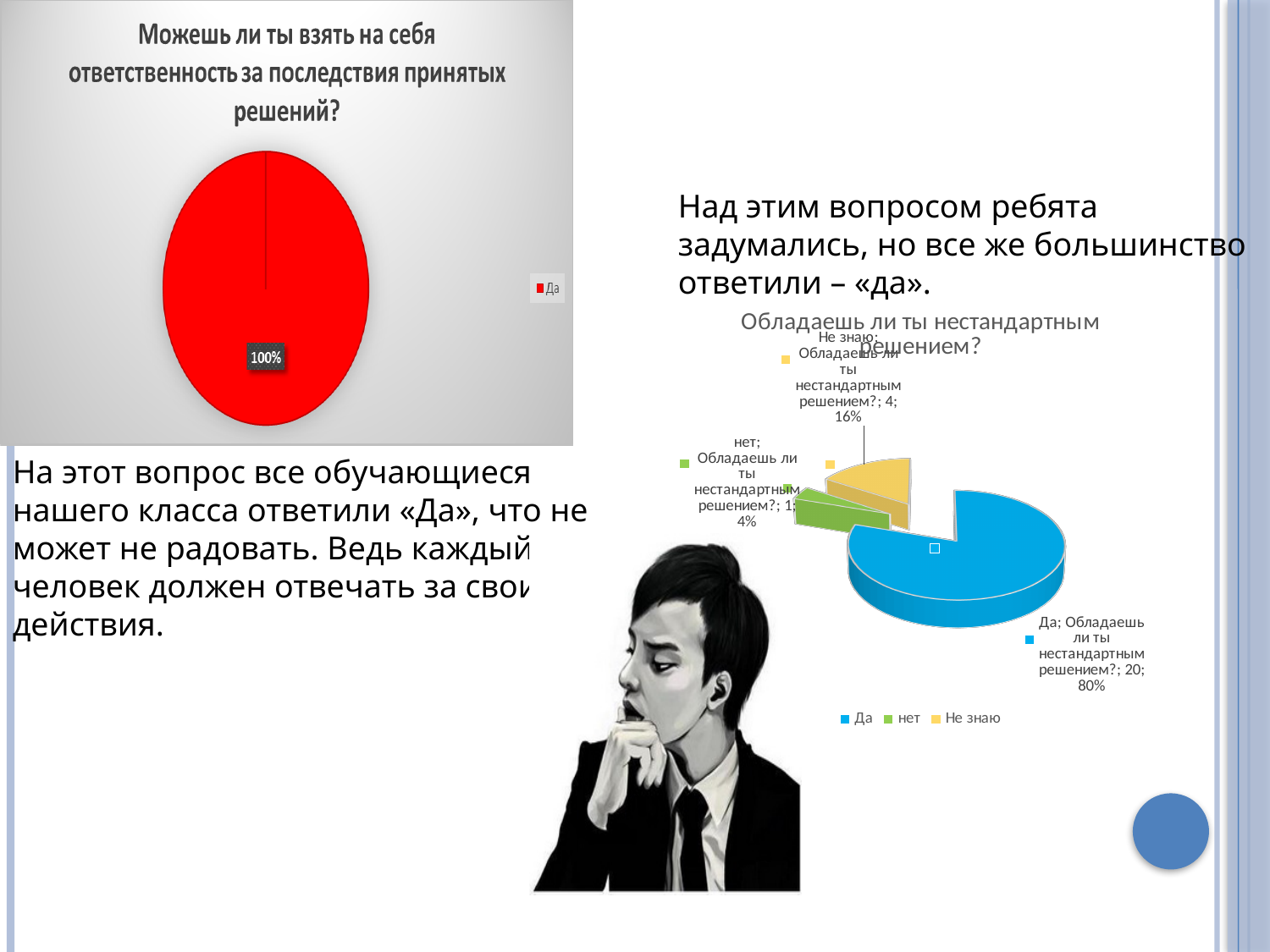
On the chart titled «Обладаешь ли ты нестандартным решением?», which answer has the largest slice? Да On the chart titled «Обладаешь ли ты нестандартным решением?», what percentage is shown for «Не знаю»? 16% On the chart titled «Обладаешь ли ты нестандартным решением?», which is larger: the «нет» slice or the «Не знаю» slice? Не знаю On the chart titled «Обладаешь ли ты нестандартным решением?», how many more respondents answered «Да» than «Не знаю»? 16 On the chart titled «Обладаешь ли ты нестандартным решением?», how many respondents answered «нет»? 1 On the chart titled «Обладаешь ли ты нестандартным решением?», which answer has the smallest slice? нет On the chart titled «Обладаешь ли ты нестандартным решением?», how many entries does the legend list? 3 On the chart titled «Обладаешь ли ты нестандартным решением?», what share of the pie is the «Да» slice? 80% On the chart titled «Обладаешь ли ты нестандартным решением?», how many respondents answered «Не знаю»? 4 What kind of chart is the one on the left titled «Можешь ли ты взять на себя ответственность за последствия принятых решений?»? Pie chart On the chart titled «Обладаешь ли ты нестандартным решением?», what colour is the «Да» slice? Blue On the left chart titled «Можешь ли ты взять на себя ответственность за последствия принятых решений?», what percentage is shown for «Да»? 100%